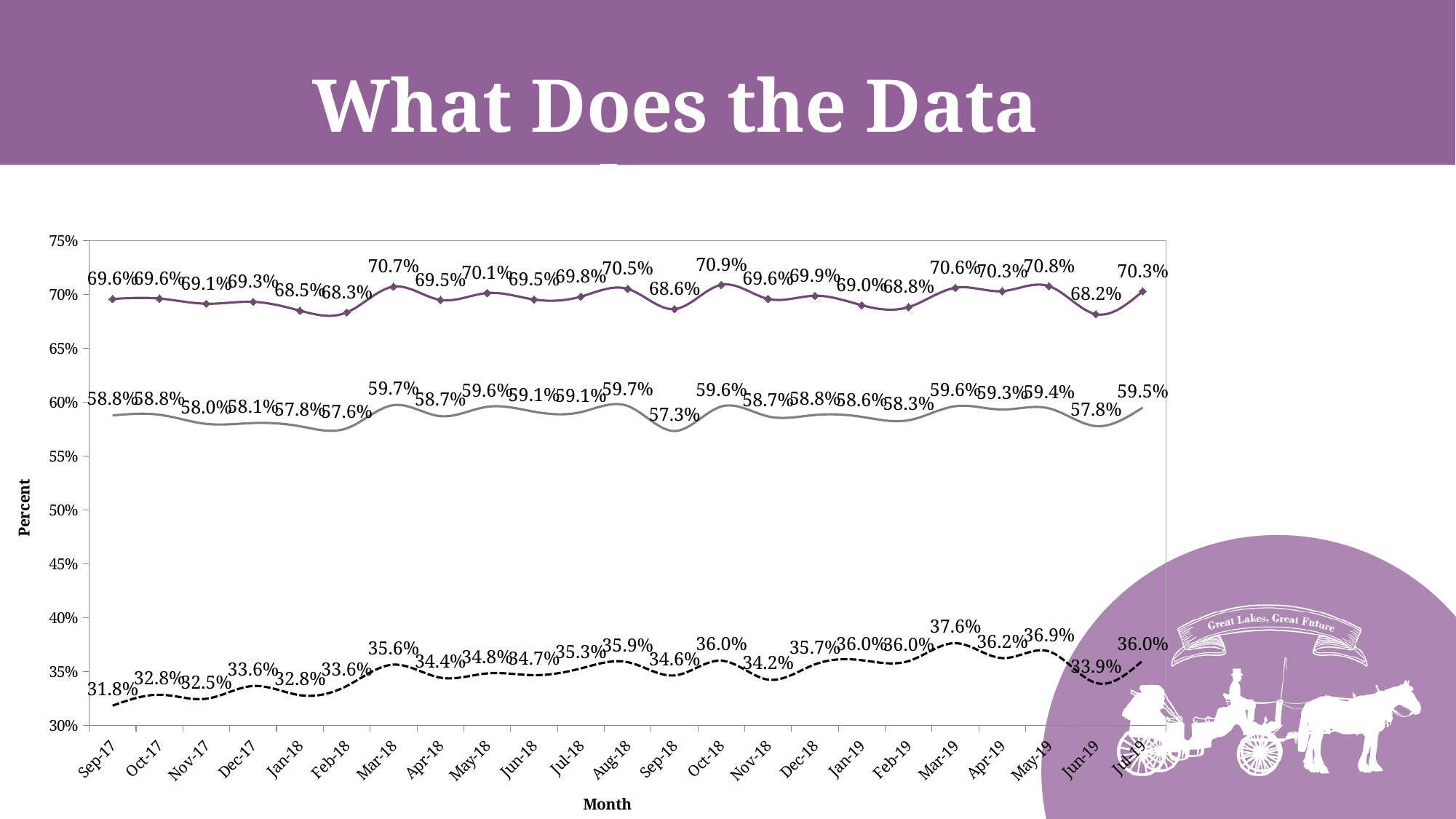
In which month is the bottom dashed line at its lowest value? Sep-17 What is the value of the middle gray line in Mar-18? 59.7% How many months are shown on the x axis? 23 In which month does the top purple line reach its lowest value? Jun-19 What is the difference between the top purple line's value in Oct-18 and its value in Jun-19? 2.7 percentage points What is the value of the top purple line in Oct-18? 70.9% What is the value of the bottom dashed line in Sep-17? 31.8% In which month does the bottom dashed line reach its highest value? Mar-19 What type of chart is shown on the slide? Line chart What is the difference between the bottom dashed line's value in Jul-19 and its value in Sep-17? 4.2 percentage points What is the value of the middle gray line in Sep-18? 57.3% For the bottom dashed line, which month has the larger value: Mar-18 or Jun-19? Mar-18